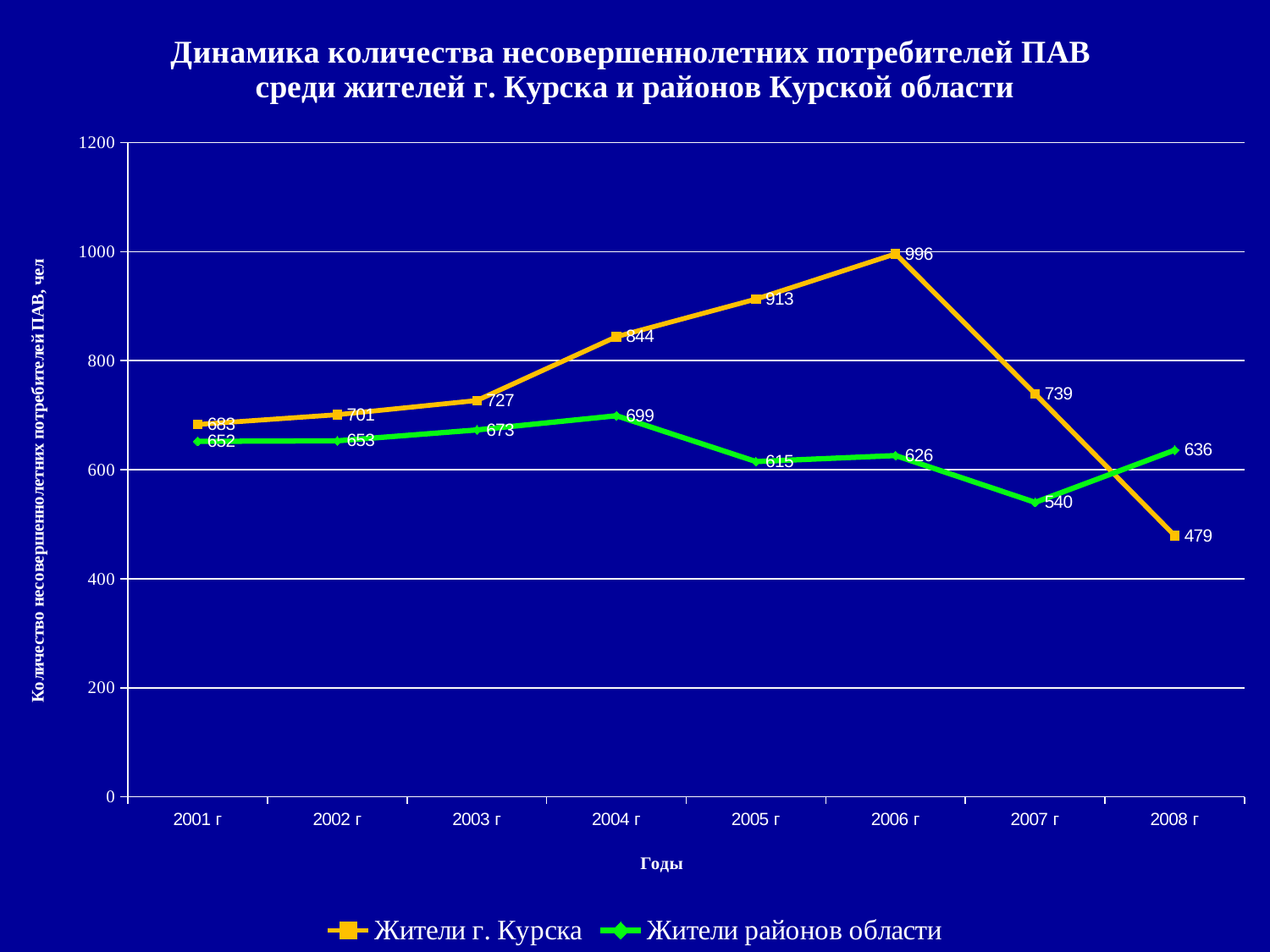
What type of chart is shown on the slide? line chart In which year does the Жители г. Курска series reach its highest value? 2006 г How many years are plotted along the x axis? 8 What is the difference between the Жители г. Курска and Жители районов области values in 2006 г? 370 How many series does the legend list? 2 Which colour is used for the Жители районов области series? green In 2008 г, which series has the larger value: Жители г. Курска or Жители районов области? Жители районов области In which year does the Жители районов области series have its lowest value? 2007 г What is the value for Жители г. Курска in 2008 г? 479 What is the value for Жители г. Курска in 2006 г? 996 What is the value for Жители районов области in 2007 г? 540 Does the Жители г. Курска series rise or fall from 2001 г to 2006 г? rise